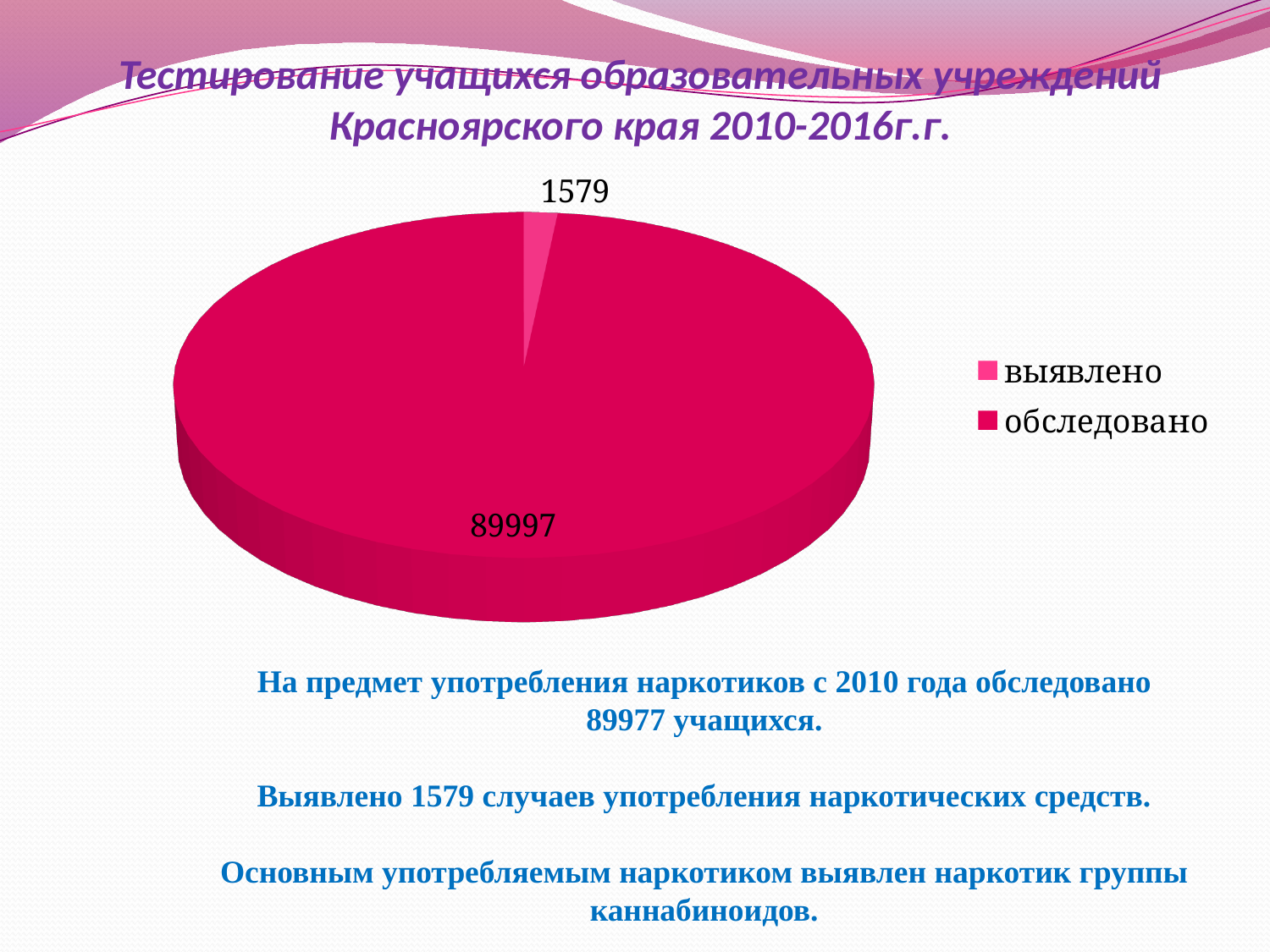
How many slices does the pie chart have? 2 What is the total of the two values shown on the pie chart? 91576 What is the value for the slice labelled "обследовано"? 89997 Which slice of the pie is the largest? обследовано What is the value for the slice labelled "выявлено"? 1579 Which legend entry is shown in the lighter pink colour? выявлено What type of chart is shown on the slide? pie chart How many entries does the legend list? 2 Which slice of the pie is the smallest? выявлено Which is larger, the value for "выявлено" or the value for "обследовано"? обследовано What is the difference between the value for "обследовано" and the value for "выявлено"? 88418 What is the title of the slide containing the chart? Тестирование учащихся образовательных учреждений Красноярского края 2010-2016г.г.